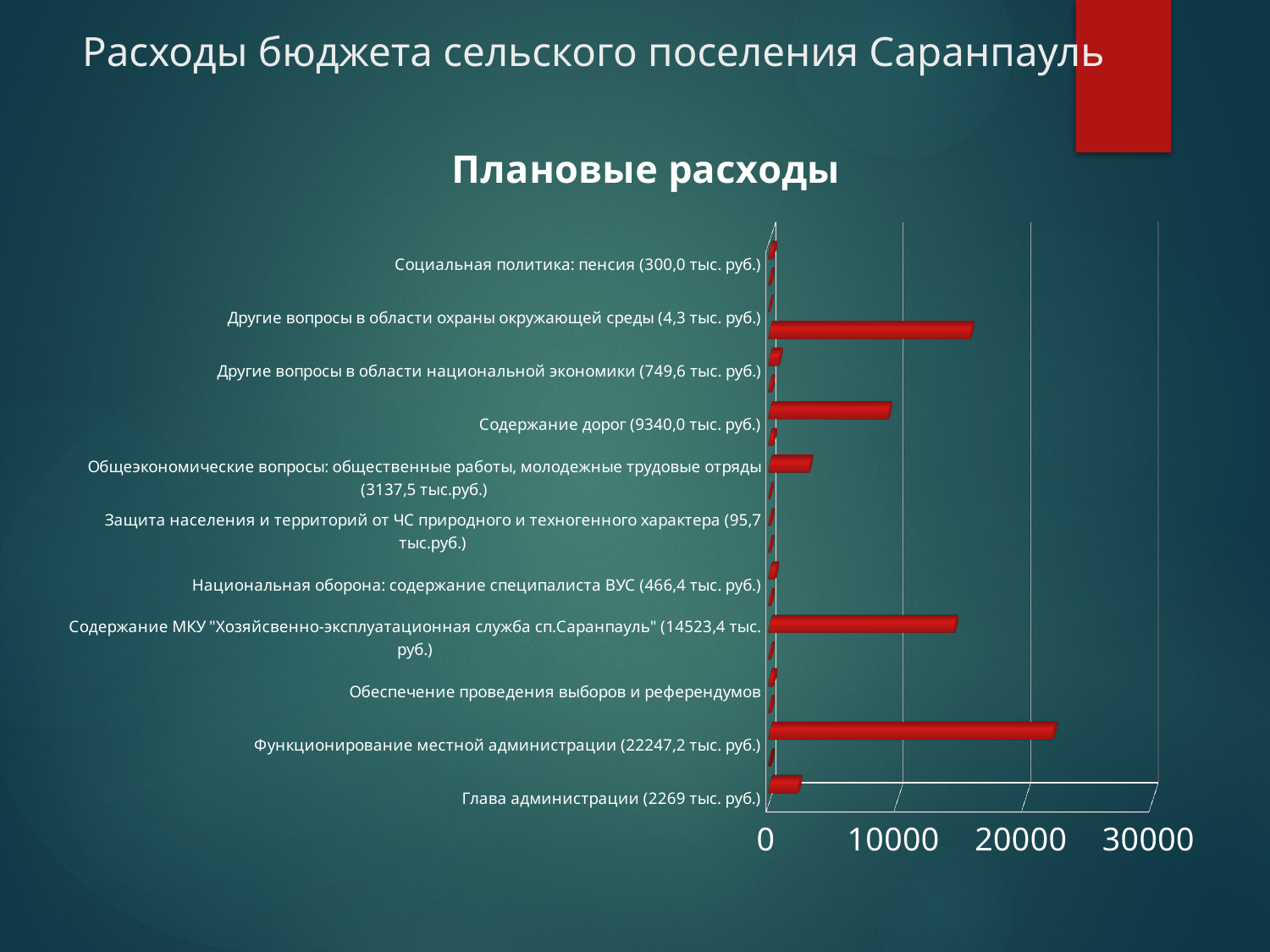
What value is given for "Функционирование местной администрации"? 22247,2 тыс. руб. Is the bar for "Функционирование местной администрации" greater or less than 20000? greater How many categories are listed on the chart's vertical axis? 11 What is the difference between "Функционирование местной администрации" (22247,2) and "Содержание МКУ" (14523,4)? 7723,8 тыс. руб. What kind of chart is shown on the slide? bar chart Which category has the highest planned expenditure? Функционирование местной администрации What value is given for "Глава администрации"? 2269 тыс. руб. What value is given for "Национальная оборона: содержание специалиста ВУС"? 466,4 тыс. руб. What value is given for "Содержание дорог"? 9340,0 тыс. руб. What colour are the bars in the chart? red What is the title of the chart? Плановые расходы Which is larger: "Содержание дорог" or "Общеэкономические вопросы: общественные работы, молодежные трудовые отряды"? Содержание дорог